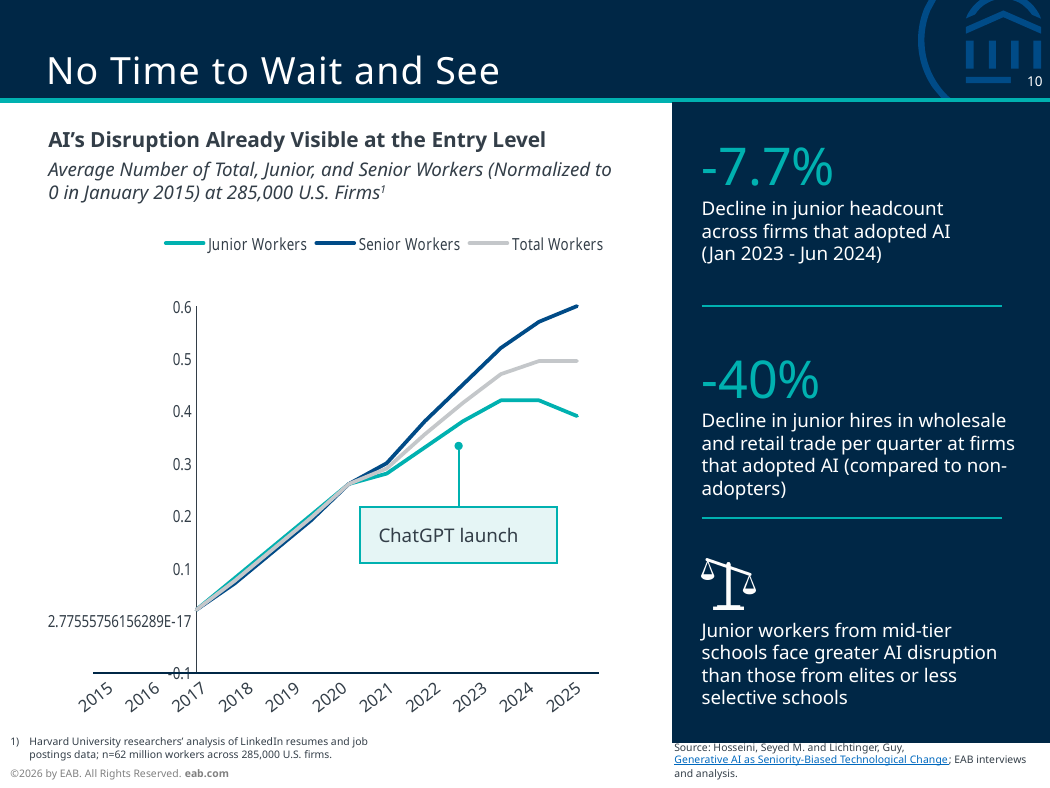
How many series does the chart's legend list? 3 What kind of chart is shown on the slide? Line chart How many year labels are shown on the x axis? 11 Which is larger in 2025, the value for Senior Workers or the value for Total Workers? Senior Workers Is the value for Junior Workers in 2025 greater or less than 0.3? greater Which series has the lowest value in 2025? Junior Workers Is the value for Total Workers in 2025 greater or less than 0.4? greater What event does the annotation on the chart mark? ChatGPT launch Is the value for Junior Workers in 2025 greater or less than 0.5? less Which series has the highest value in 2025? Senior Workers Does the Junior Workers line rise or fall between 2024 and 2025? Fall